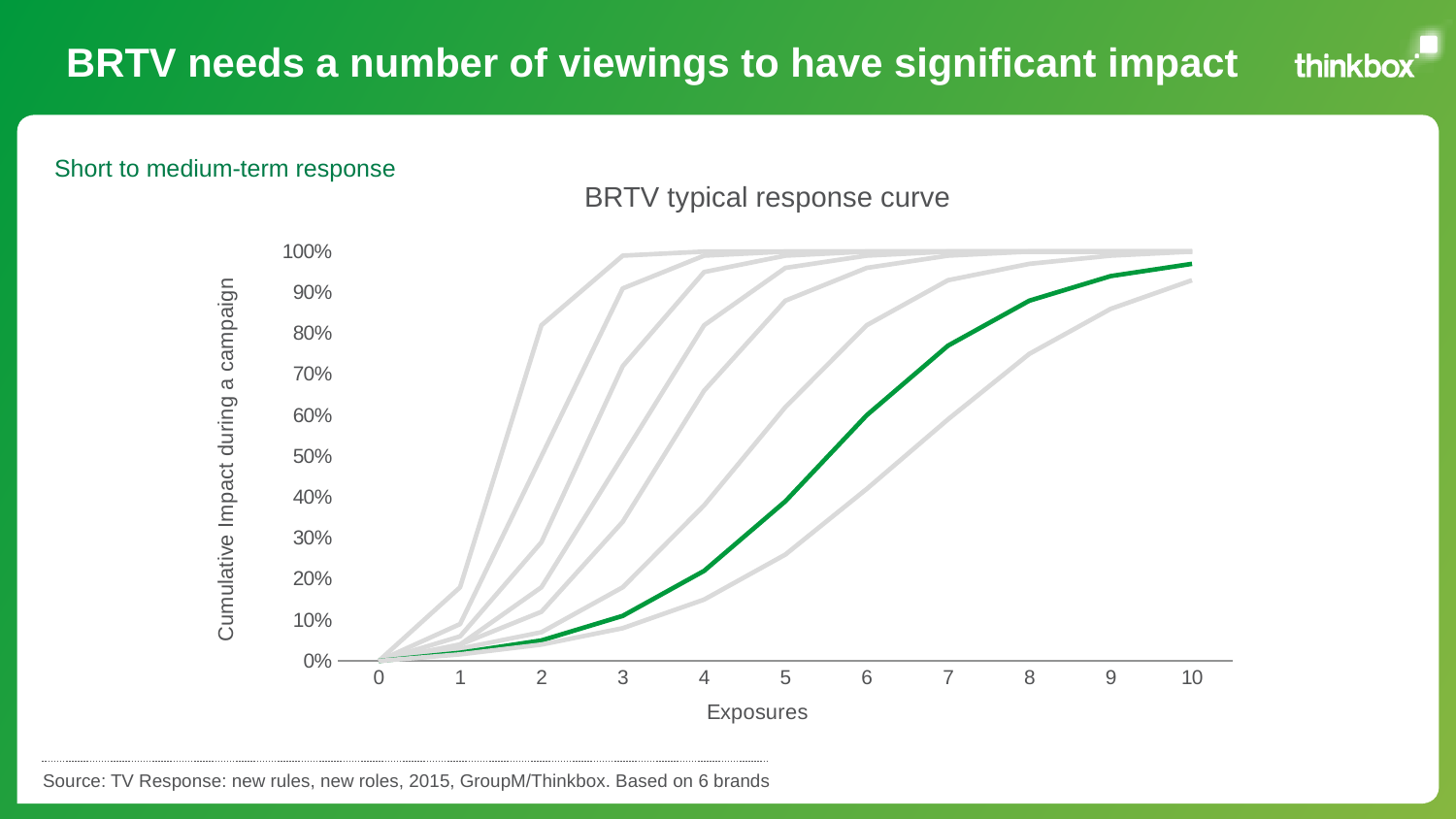
What is the highest value shown on the vertical axis? 100% Is the value of the green line at 10 exposures greater or less than 90%? greater Is the green line's value at 8 exposures larger or smaller than its value at 4 exposures? larger Is the value of the green line at 5 exposures greater or less than 50%? less Does the green line rise or fall as the number of exposures increases? rise What kind of chart is shown on the slide? line chart What is the label of the vertical axis? Cumulative Impact during a campaign Is the value of the green line at 2 exposures greater or less than 10%? less What is the title of the chart? BRTV typical response curve How many exposure values are marked on the x axis? 11